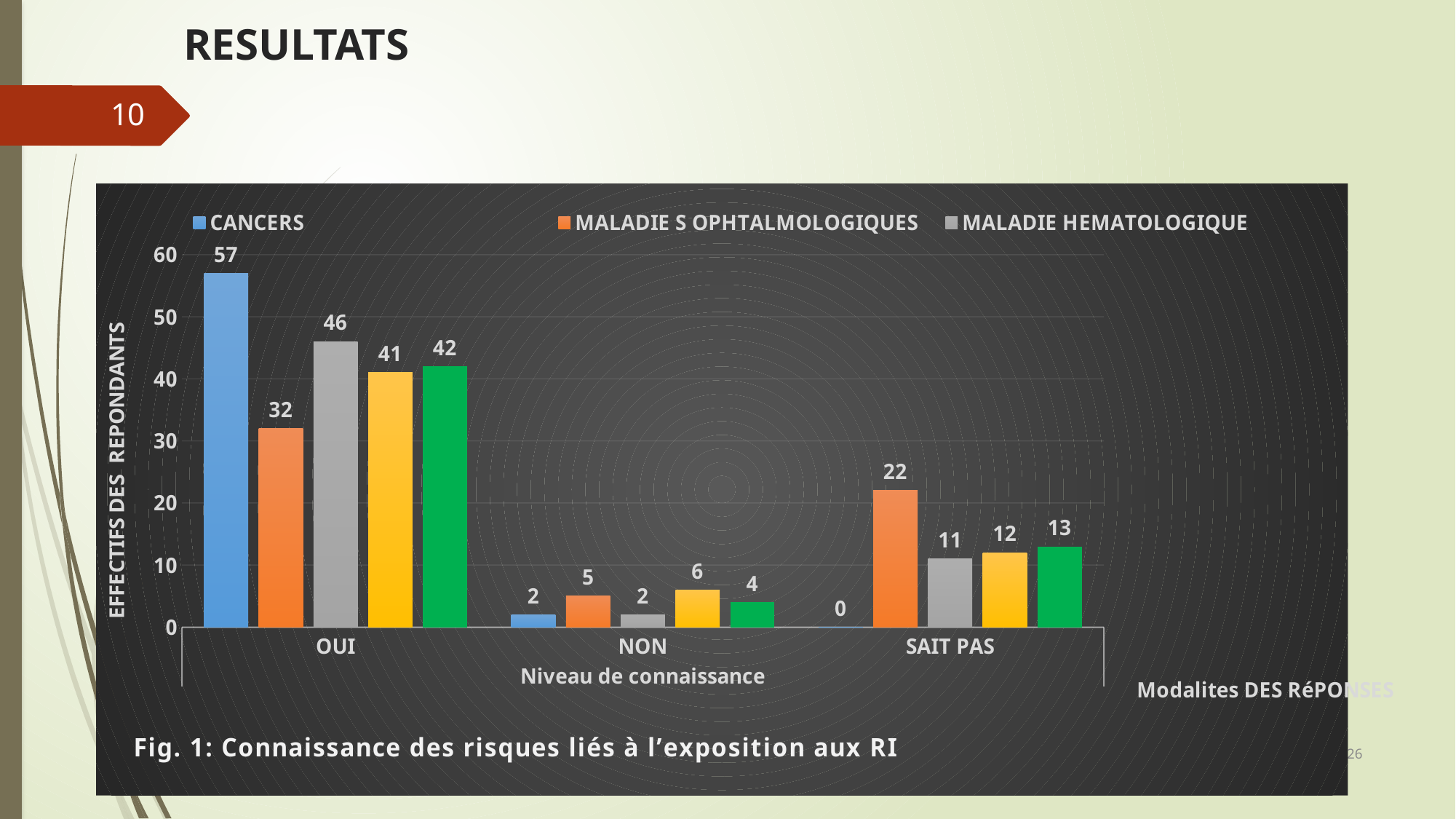
In the OUI category, which is larger: MALADIE HEMATOLOGIQUE or MALADIE S OPHTALMOLOGIQUES? MALADIE HEMATOLOGIQUE What is the value for MALADIE S OPHTALMOLOGIQUES in the SAIT PAS category? 22 What is the value for CANCERS in the OUI category? 57 In which category is the MALADIE HEMATOLOGIQUE value lowest? NON In which category is the CANCERS value highest? OUI What is the value for CANCERS in the SAIT PAS category? 0 What kind of chart is shown on the slide? Bar chart How many categories are shown on the x axis? 3 What is the value for MALADIE S OPHTALMOLOGIQUES in the NON category? 5 What is the difference between the CANCERS value and the MALADIE S OPHTALMOLOGIQUES value in the OUI category? 25 How many series does the legend list? 3 What is the value for MALADIE HEMATOLOGIQUE in the OUI category? 46